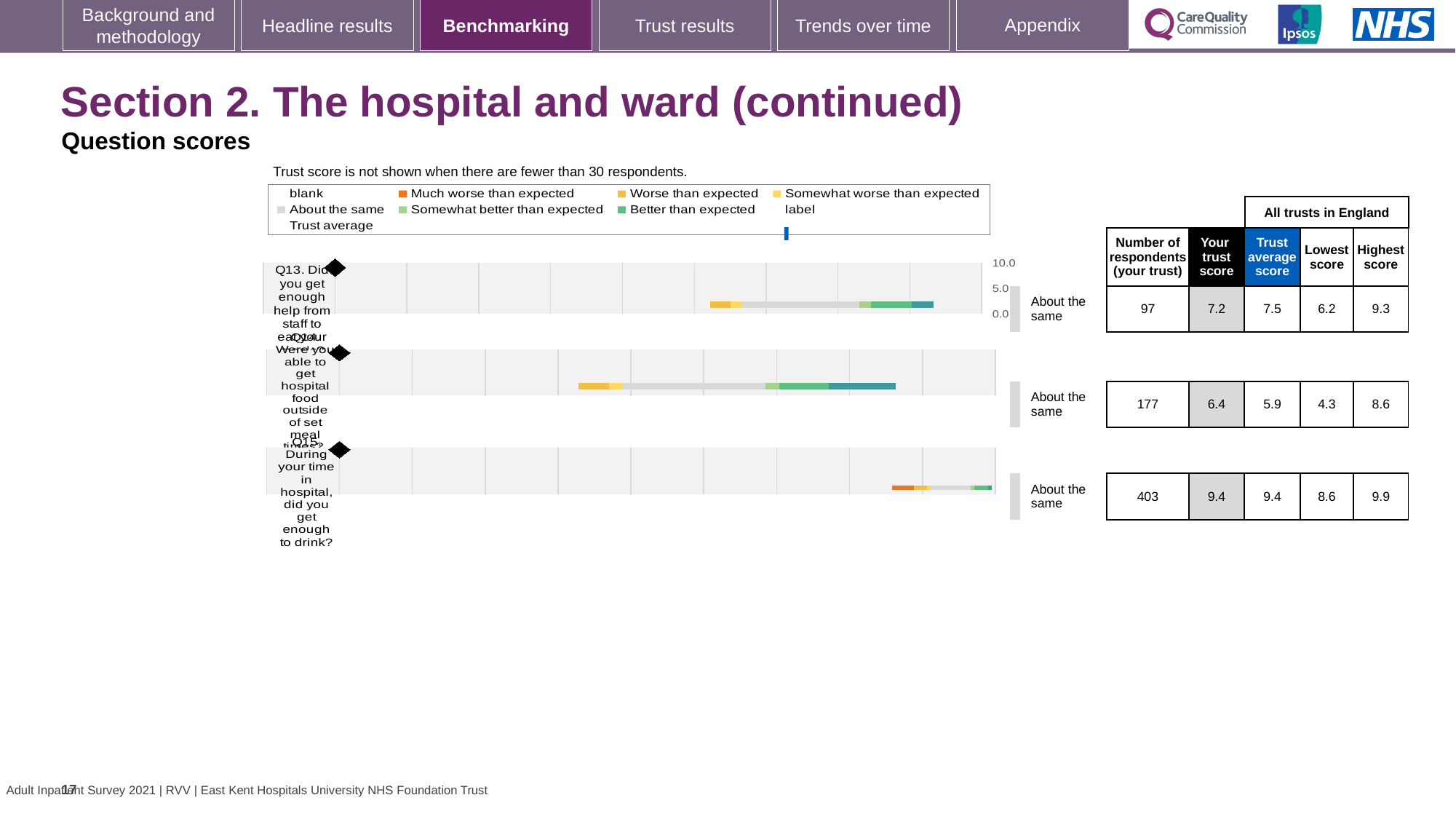
What kind of chart is used to show the question scores on this slide? bar chart How many questions (categories) are plotted in the chart? 3 What is the trust average score for Q14 (able to get hospital food outside of set meal times)? 5.9 Which question has the lowest trust score? Q14 What is the number of respondents for Q15 (did you get enough to drink?)? 403 What is the difference between the highest and lowest scores for Q14? 4.3 Is the trust score for Q13 larger or smaller than the trust average score for Q13? smaller What is the benchmark category shown for Q15? About the same What is the trust score for Q13 (Did you get enough help from staff to eat your meals?)? 7.2 What is the highest score across all trusts in England for Q15? 9.9 Which question has the highest number of respondents? Q15 What is the difference between the trust score and the trust average score for Q14? 0.5